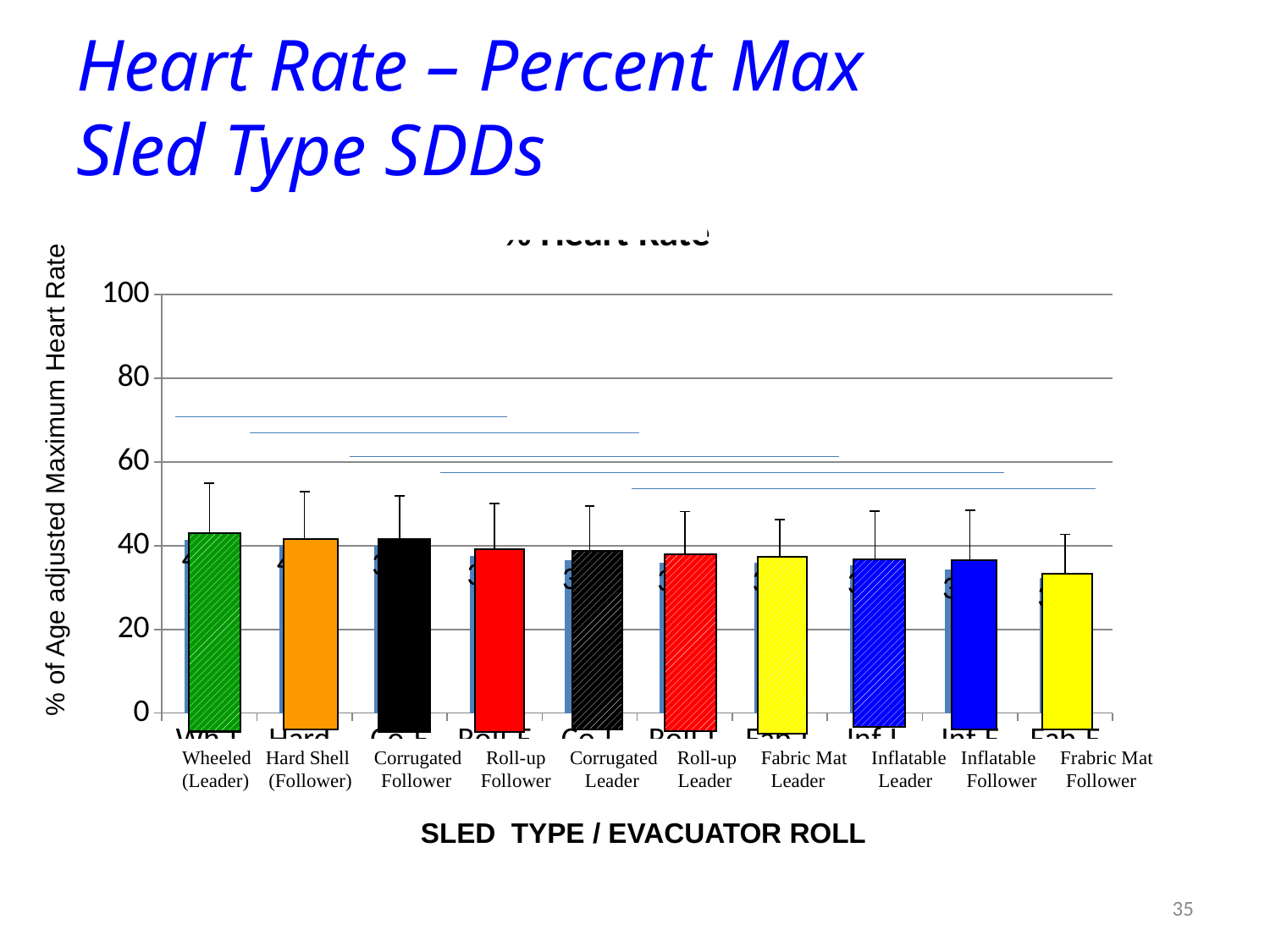
What kind of chart is shown on the slide? bar chart Which category has the highest bar on the chart? Wheeled (Leader) Is the value for Corrugated Follower greater or less than 60? less Which category has the lowest bar on the chart? Frabric Mat Follower Is the value for Frabric Mat Follower greater or less than 40? less What is the title of the x axis of the chart? SLED TYPE / EVACUATOR ROLL Is the value for Inflatable Leader greater or less than 40? less Which is larger, the value for Corrugated Follower or the value for Inflatable Follower? Corrugated Follower Do the bar values generally rise or fall moving from left to right along the x axis? fall Which is larger, the value for Wheeled (Leader) or the value for Frabric Mat Follower? Wheeled (Leader) How many sled type / evacuator roll categories are plotted on the chart? 10